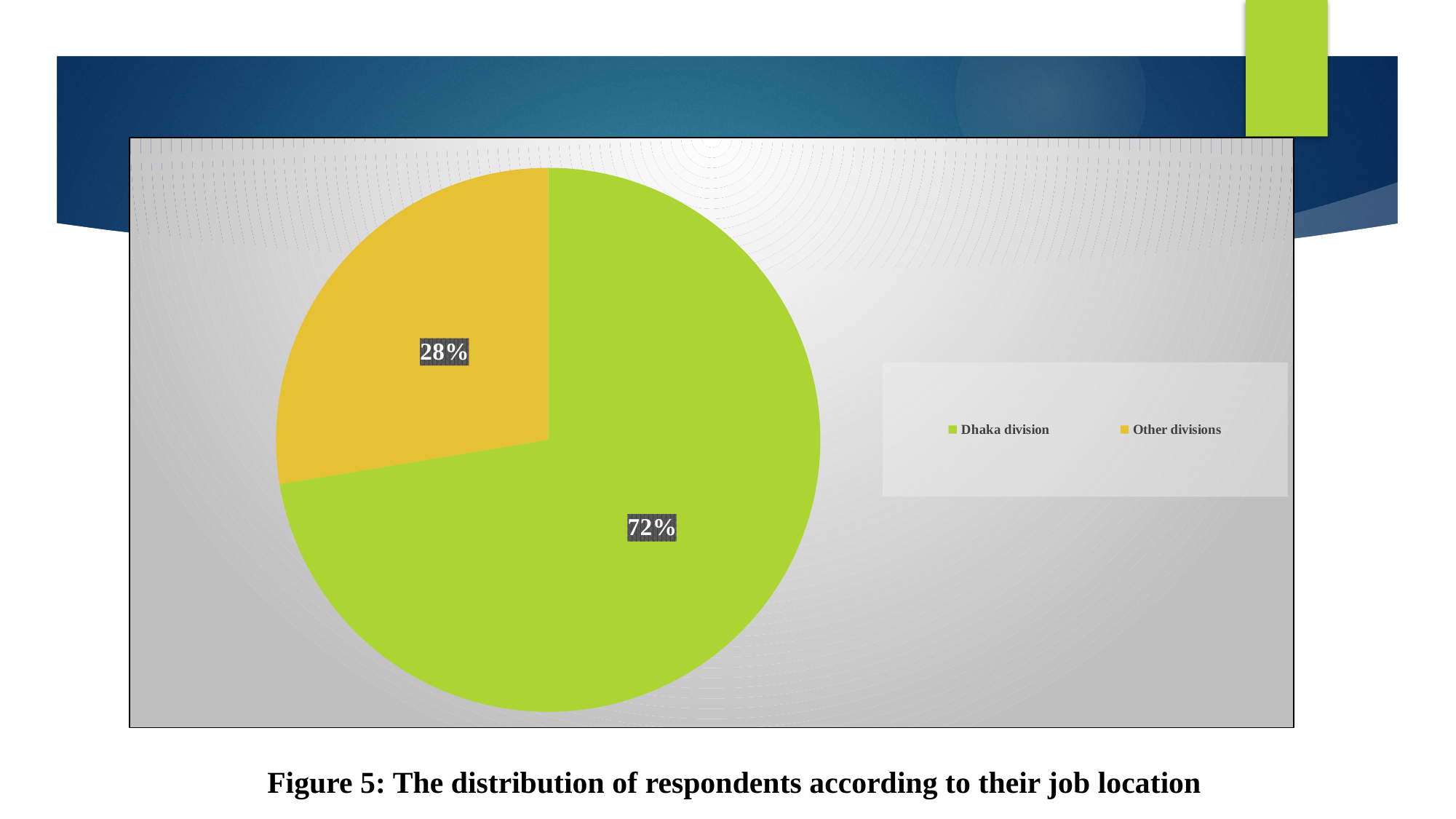
What colour is the Dhaka division slice? green What kind of chart is shown on the slide? pie chart How many entries does the legend list? 2 What is the figure caption below the chart? Figure 5: The distribution of respondents according to their job location Which category has the smallest slice of the pie? Other divisions What share of respondents are in Other divisions? 28% What is the difference in percentage points between the Dhaka division and Other divisions slices? 44 Which category has the largest slice of the pie? Dhaka division Which is larger, the Dhaka division slice or the Other divisions slice? Dhaka division What share of respondents are in the Dhaka division? 72% How many slices does the pie chart have? 2